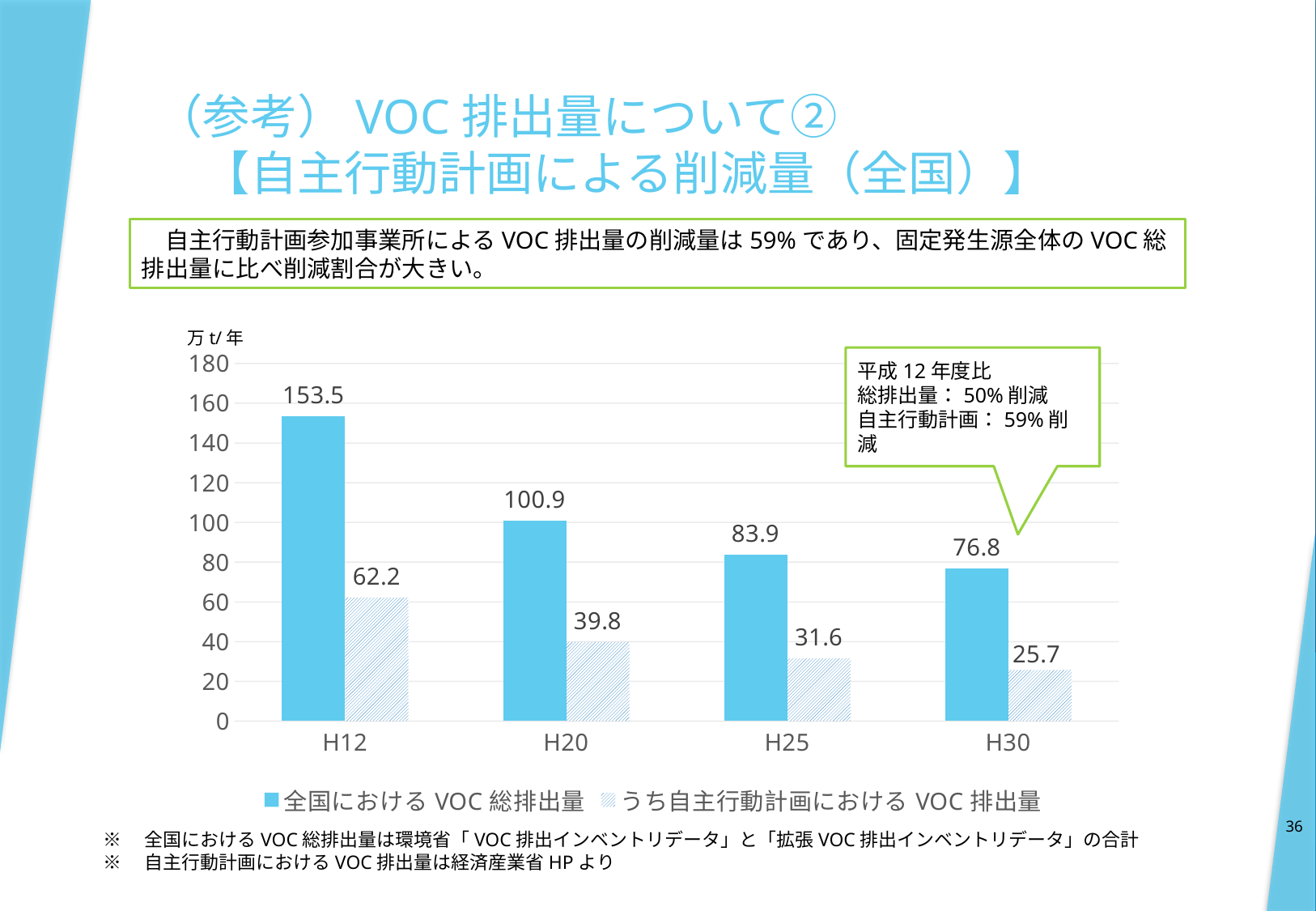
Do the values for 全国におけるVOC総排出量 rise or fall from H12 to H30? Fall Which is larger: 全国におけるVOC総排出量 for H30 or うち自主行動計画におけるVOC排出量 for H12? 全国におけるVOC総排出量 for H30 Which year has the highest value for 全国におけるVOC総排出量? H12 What unit is shown above the vertical axis of the chart? 万t/年 What kind of chart is shown on the slide? Bar chart What is the difference between 全国におけるVOC総排出量 and うち自主行動計画におけるVOC排出量 for H20? 61.1 Which year has the lowest value for うち自主行動計画におけるVOC排出量? H30 What is the value of 全国におけるVOC総排出量 for H12? 153.5 What is the value of 全国におけるVOC総排出量 for H25? 83.9 How many series does the legend list? 2 What is the value of うち自主行動計画におけるVOC排出量 for H30? 25.7 How many years are shown on the x axis? 4